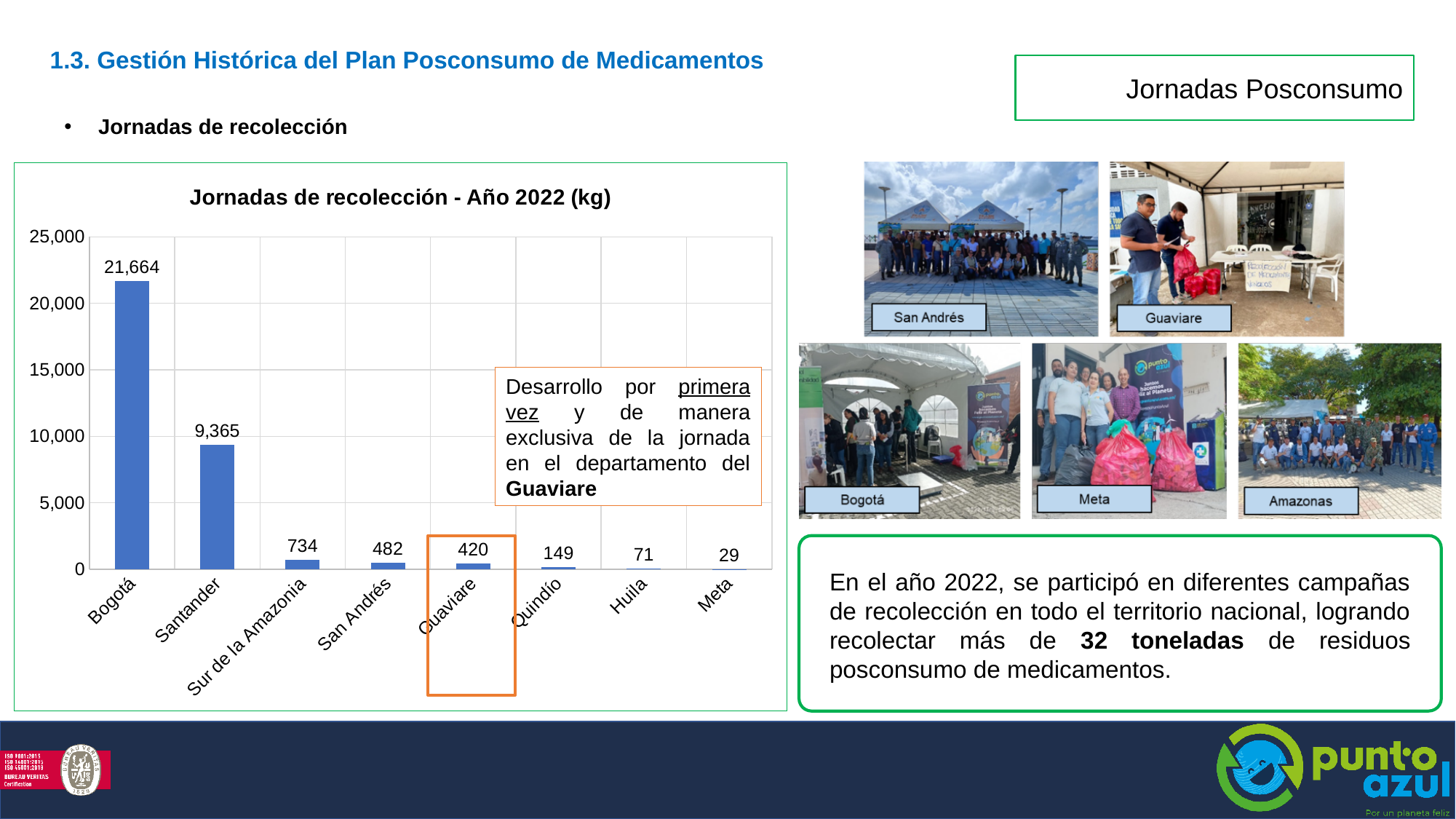
How many categories are shown in the chart? 8 What is the difference between the values for Bogotá and Santander? 12,299 What kind of chart is shown on the slide? Bar chart Which category has the highest value in the chart? Bogotá What is the title of the chart on the slide? Jornadas de recolección - Año 2022 (kg) What is the value for Santander in the chart? 9,365 Which is larger, the value for Quindío or the value for Huila? Quindío What is the value for Bogotá in the chart 'Jornadas de recolección - Año 2022 (kg)'? 21,664 Which category has the lowest value in the chart? Meta What is the value for Meta in the chart? 29 What is the value for Guaviare in the chart? 420 What is the difference between the values for Sur de la Amazonia and San Andrés? 252